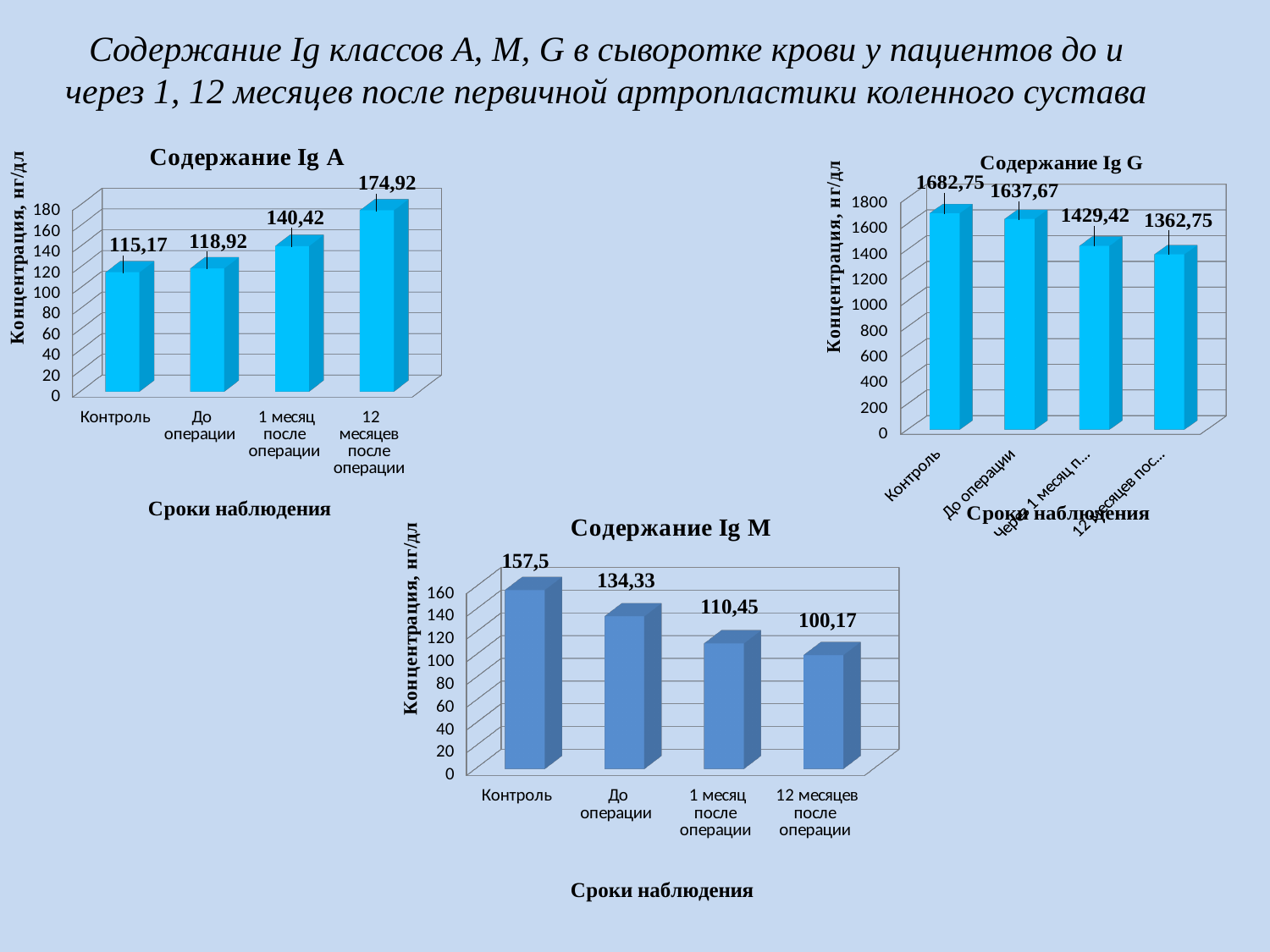
What kind of chart is the chart titled "Содержание Ig A"? bar chart In the chart titled "Содержание Ig M", which category has the lowest value? 12 месяцев после операции In the chart titled "Содержание Ig G", what is the value for "Контроль"? 1682,75 In the chart titled "Содержание Ig M", which is larger: the value for "Контроль" or the value for "1 месяц после операции"? Контроль In the chart titled "Содержание Ig A", which category has the lowest value? Контроль In the chart titled "Содержание Ig G", what is the difference between the values for "Контроль" and the last category (12 месяцев после операции)? 320 In the chart titled "Содержание Ig A", do the values rise or fall from left to right along the x axis? rise In the chart titled "Содержание Ig A", what is the difference between the values for "12 месяцев после операции" and "Контроль"? 59,75 In the chart titled "Содержание Ig A", what is the value for "12 месяцев после операции"? 174,92 In the chart titled "Содержание Ig G", which category has the highest value? Контроль In the chart titled "Содержание Ig M", what is the value for "До операции"? 134,33 How many categories are shown in the chart titled "Содержание Ig M"? 4